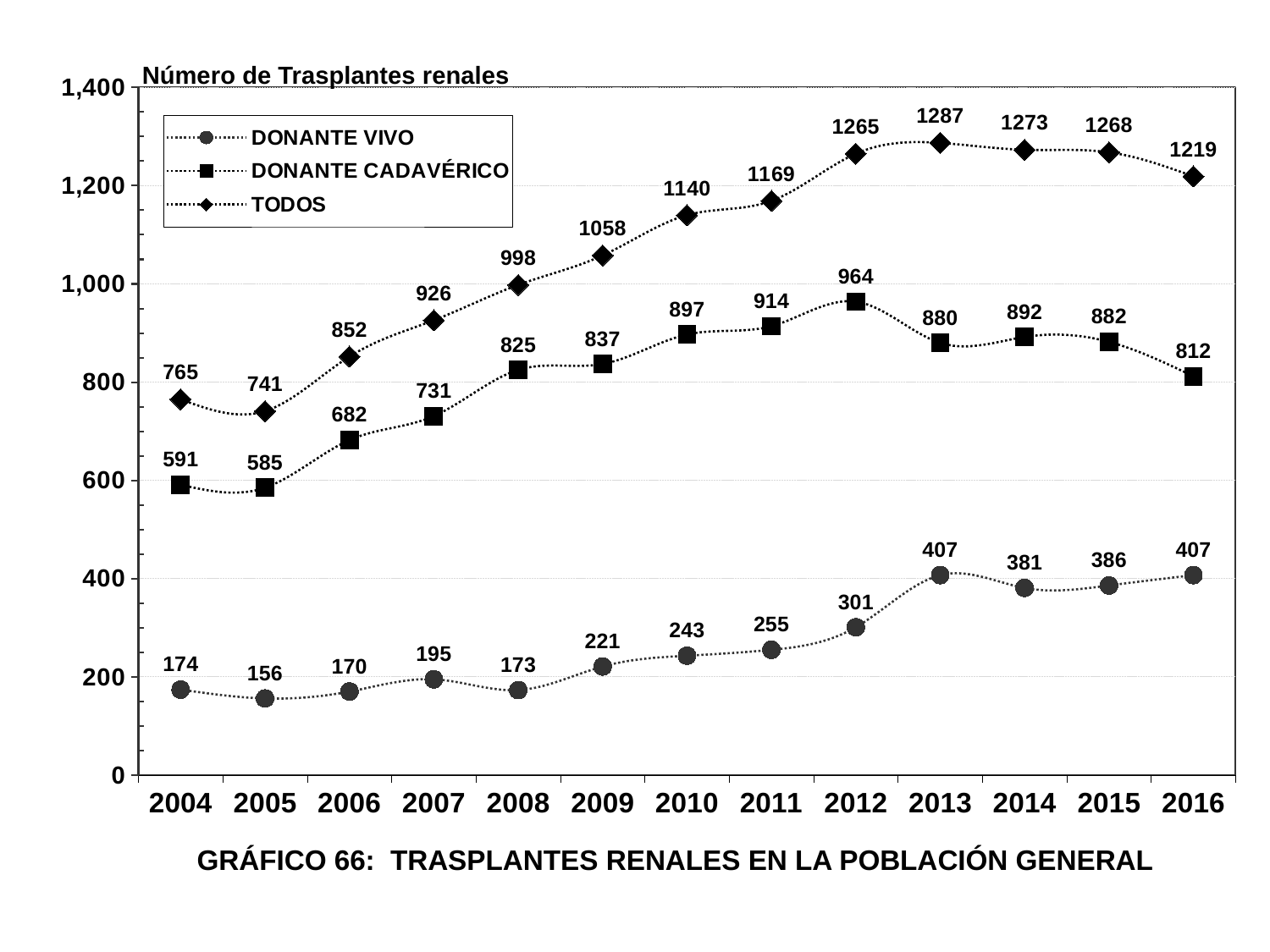
What is the difference between the TODOS value in 2016 and the DONANTE CADAVÉRICO value in 2016? 407 What is the value for DONANTE VIVO in 2012? 301 What kind of chart is this? line chart In which year is the DONANTE VIVO series lowest? 2005 Does the DONANTE VIVO series generally rise or fall from 2004 to 2016? rise What is the value for TODOS in 2010? 1140 How many years are shown on the x axis? 13 In which year is the TODOS series highest? 2013 What is the title of the chart? GRÁFICO 66: TRASPLANTES RENALES EN LA POBLACIÓN GENERAL What is the value for DONANTE CADAVÉRICO in 2007? 731 How many series does the legend list? 3 Which is larger: DONANTE CADAVÉRICO in 2012 or DONANTE CADAVÉRICO in 2013? DONANTE CADAVÉRICO in 2012